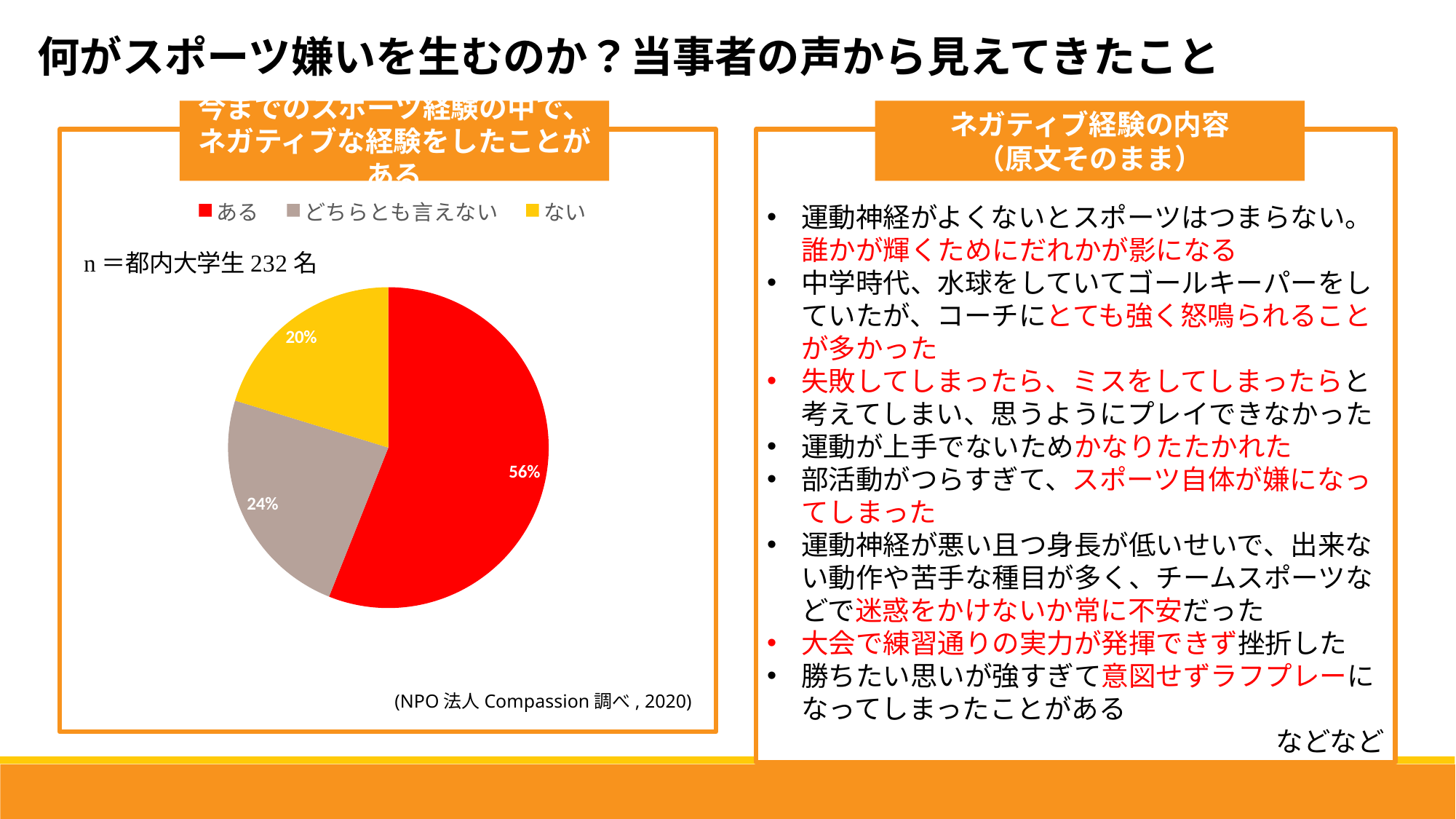
How many slices does the pie chart have? 3 What is the difference in percentage points between the ある slice and the ない slice? 36 What percentage of the pie chart is the ない slice? 20% What percentage of the pie chart is the ある slice? 56% Which slice of the pie chart is the largest? ある Which is larger in the pie chart, the どちらとも言えない slice or the ない slice? どちらとも言えない What percentage of the pie chart is the どちらとも言えない slice? 24% How many entries does the pie chart's legend list? 3 Which slice of the pie chart is the smallest? ない What is the difference in percentage points between the どちらとも言えない slice and the ない slice? 4 What colour is the ある slice in the pie chart? red What kind of chart is shown on the slide? pie chart